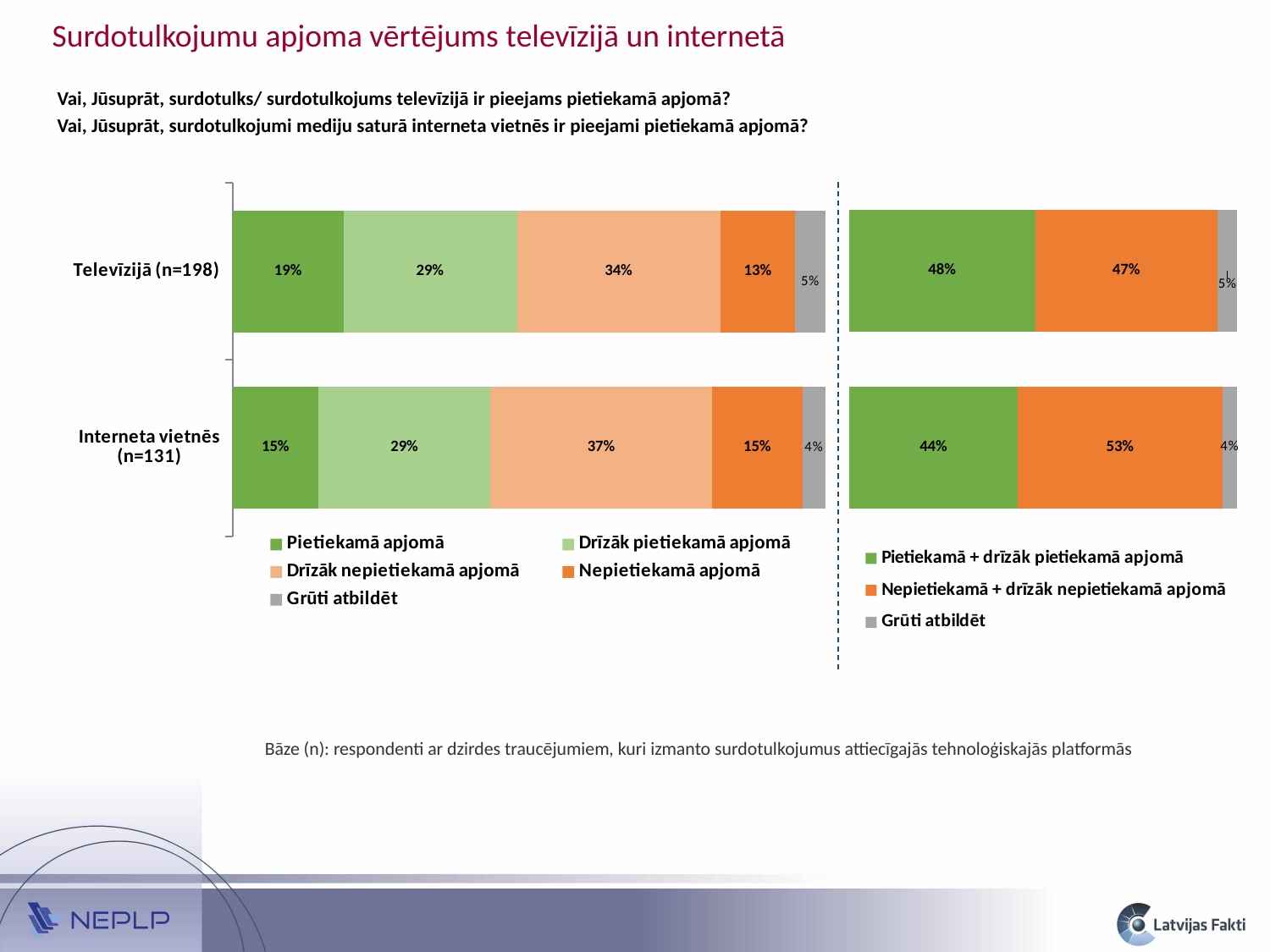
In the left chart, which segment is the largest for Televīzijā (n=198)? Drīzāk nepietiekamā apjomā In the left chart, what is the value for "Drīzāk nepietiekamā apjomā" for Interneta vietnēs (n=131)? 37% What kind of chart is the left chart? Stacked bar chart In the left chart, what is the difference between the "Nepietiekamā apjomā" values for Interneta vietnēs (n=131) and Televīzijā (n=198)? 2% In the right chart, what is the value for "Pietiekamā + drīzāk pietiekamā apjomā" for Televīzijā (n=198)? 48% How many categories (bars) are shown in the right chart? 2 In the left chart, which segment is the smallest for Interneta vietnēs (n=131)? Grūti atbildēt In the right chart, what is the value for "Nepietiekamā + drīzāk nepietiekamā apjomā" for Interneta vietnēs (n=131)? 53% How many series does the legend of the right chart list? 3 How many series does the legend of the left chart list? 5 In the right chart, which is larger for Interneta vietnēs (n=131): "Pietiekamā + drīzāk pietiekamā apjomā" or "Nepietiekamā + drīzāk nepietiekamā apjomā"? Nepietiekamā + drīzāk nepietiekamā apjomā In the left chart, what is the value for "Pietiekamā apjomā" for Televīzijā (n=198)? 19%